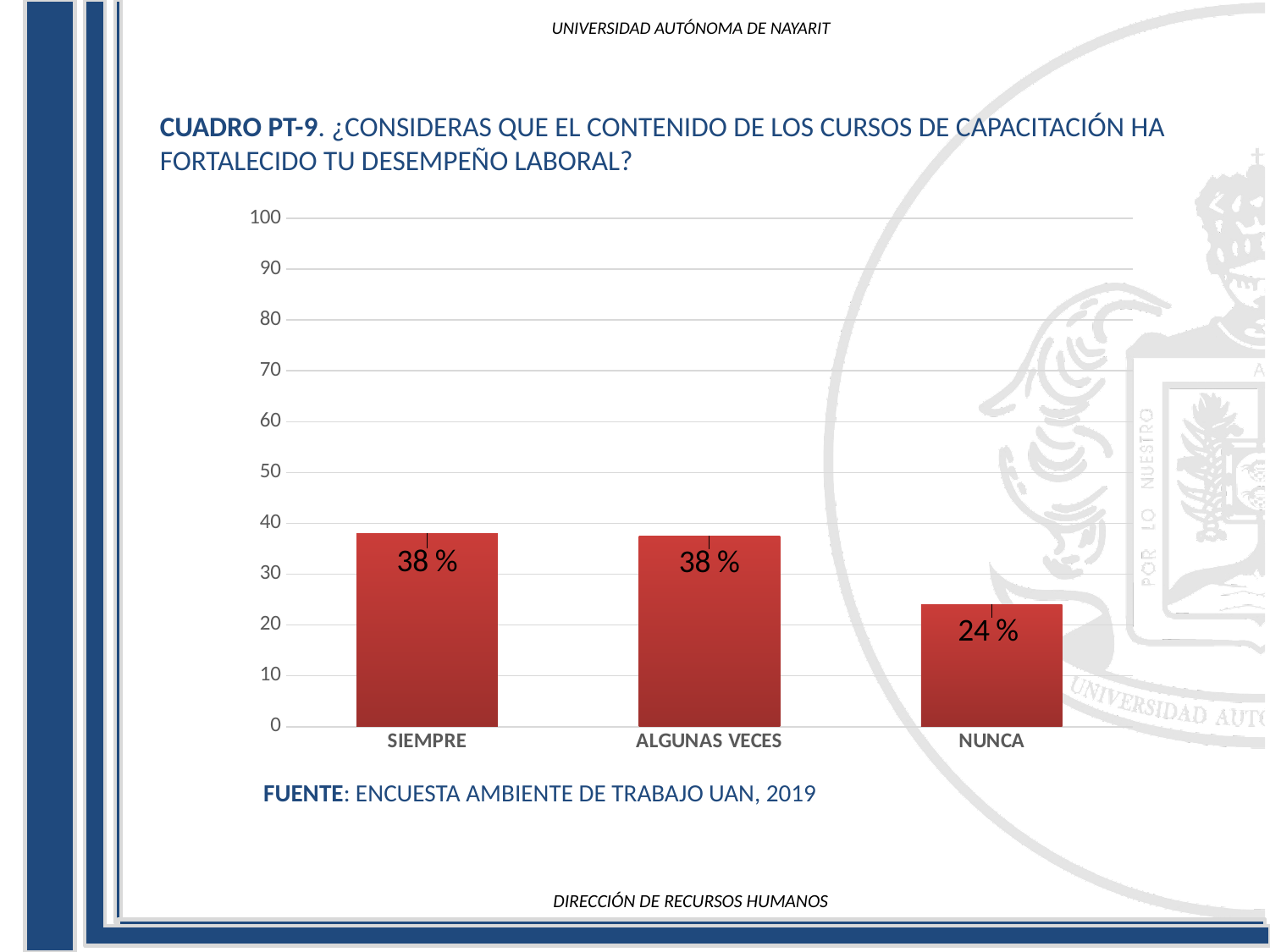
What is the maximum value shown on the vertical axis? 100 What source is cited below the chart? ENCUESTA AMBIENTE DE TRABAJO UAN, 2019 What is the value for SIEMPRE? 38 % What kind of chart is shown on the slide? bar chart Which is larger, the value for ALGUNAS VECES or the value for NUNCA? ALGUNAS VECES How many categories are shown on the x axis? 3 Which category has the lowest value? NUNCA Is the value for NUNCA greater or less than 30? less What is the value for ALGUNAS VECES? 38 % Is the value for SIEMPRE greater or less than 30? greater What is the value for NUNCA? 24 % What is the difference between the values for SIEMPRE and NUNCA? 14 %